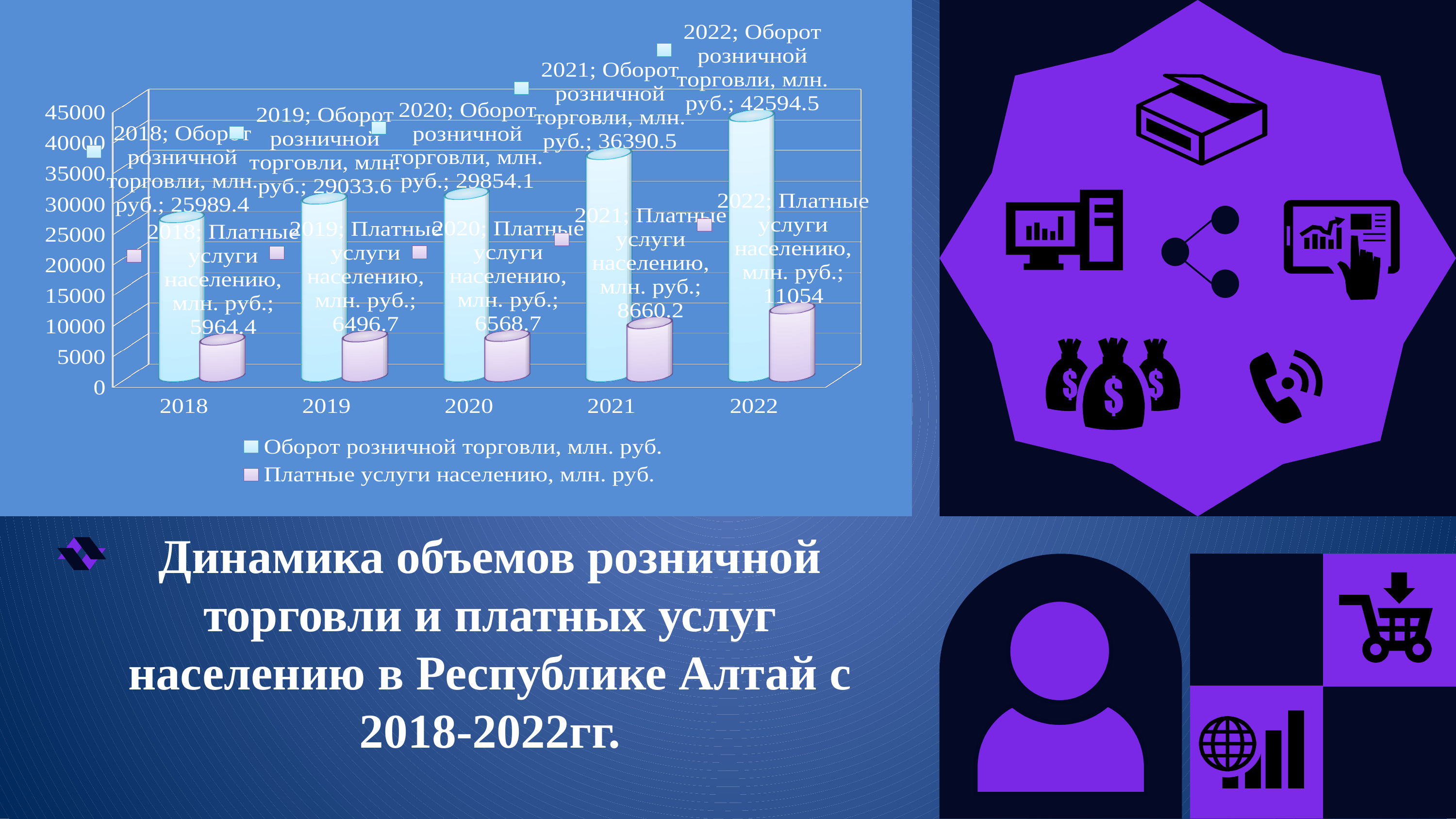
In which year is Платные услуги населению, млн. руб. the lowest? 2018 How many series does the chart legend list? 2 Is the value of Оборот розничной торговли, млн. руб. for 2021 greater or less than 35000? greater What is the difference between Платные услуги населению, млн. руб. in 2022 and in 2018? 5089.6 Which is larger: Оборот розничной торговли, млн. руб. in 2021 or in 2019? 2021 What is the value of Платные услуги населению, млн. руб. for 2018? 5964.4 What is the value of Платные услуги населению, млн. руб. for 2021? 8660.2 What is the value of Оборот розничной торговли, млн. руб. for 2022? 42594.5 How many years are shown on the x axis of the chart? 5 In which year is Оборот розничной торговли, млн. руб. the highest? 2022 What is the difference between Оборот розничной торговли, млн. руб. in 2022 and in 2021? 6204 What is the value of Оборот розничной торговли, млн. руб. for 2020? 29854.1